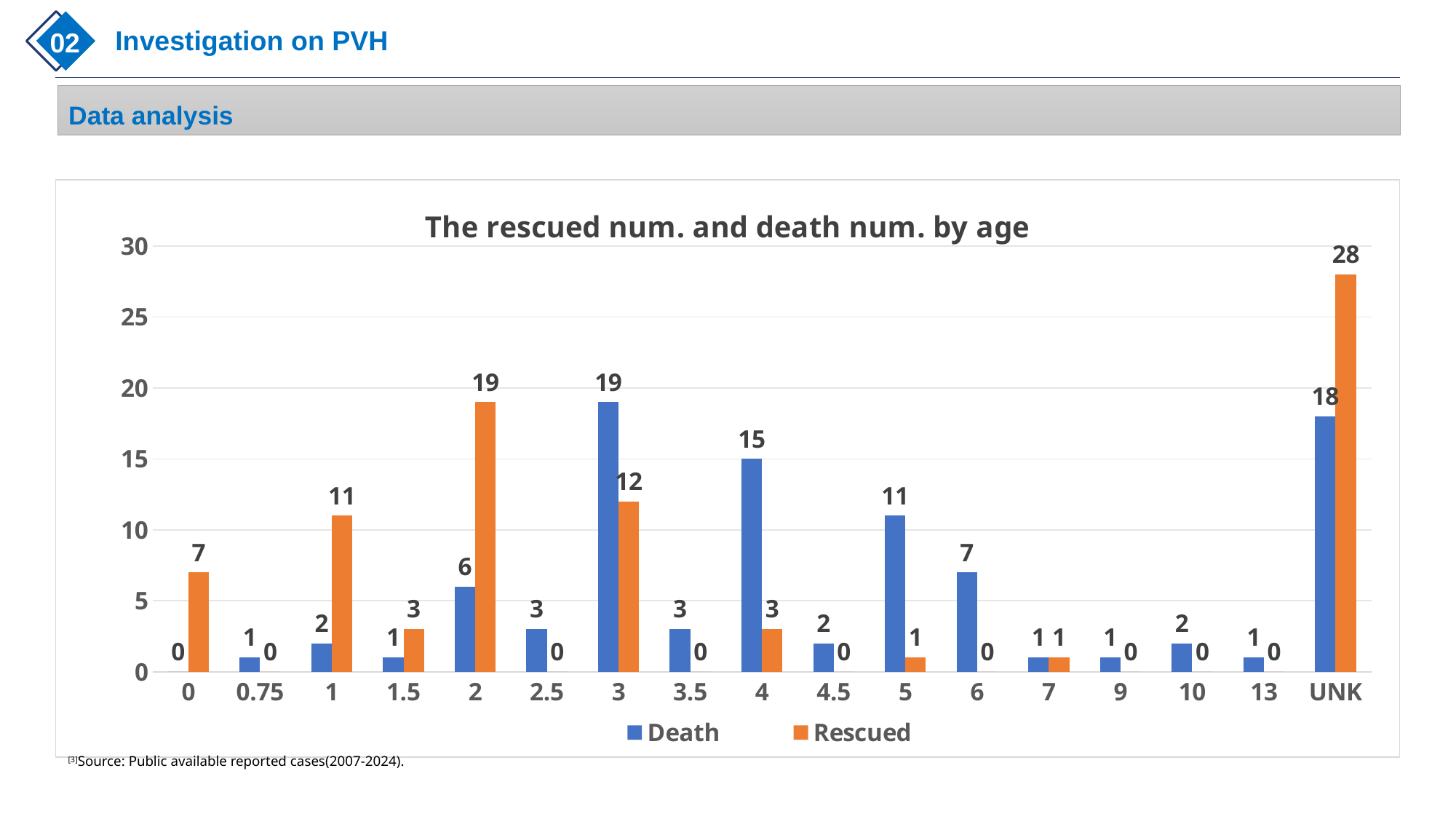
How many age categories are shown on the x axis? 17 Which category has the highest Rescued value? UNK What is the title of the chart? The rescued num. and death num. by age For age 4, which is larger, the Death value or the Rescued value? Death Which age category has the highest Death value? 3 How many series does the legend list? 2 What is the difference between the Rescued and Death values for the UNK category? 10 What is the Death value for the UNK category? 18 What is the Death value for age 3? 19 Which colour represents the Rescued series? Orange What kind of chart is shown on the slide? Bar chart What is the Rescued value for age 2? 19